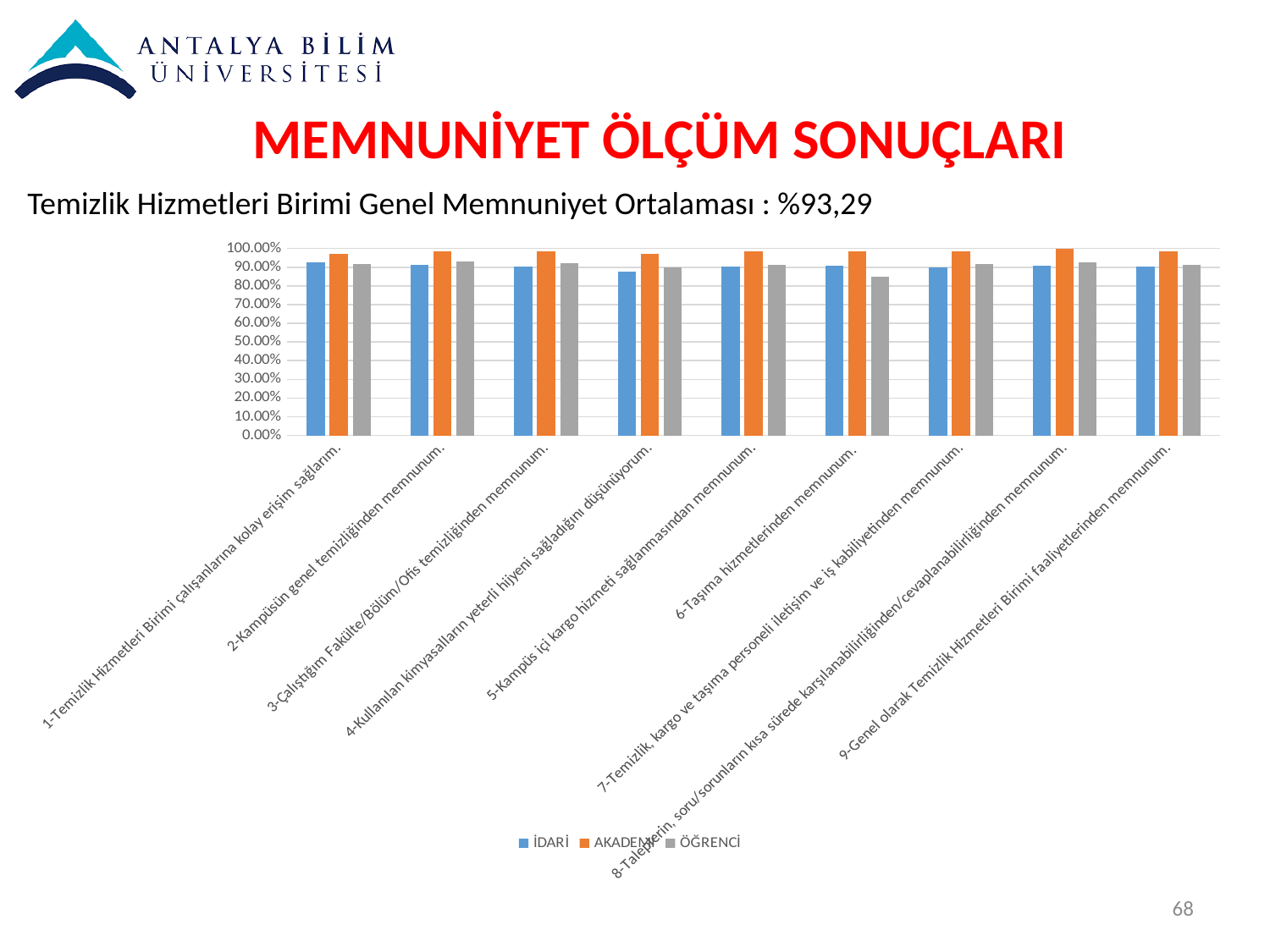
How many categories (survey statements) are shown on the x axis? 9 Which series is shown in grey in the legend? ÖĞRENCİ For "4-Kullanılan kimyasalların yeterli hijyeni sağladığını düşünüyorum.", which is larger: the İDARİ value or the AKADEMİ value? AKADEMİ Is the ÖĞRENCİ value for "6-Taşıma hizmetlerinden memnunum." greater or less than 90.00%? less Is the AKADEMİ value for "8-Taleplerin, soru/sorunların kısa sürede karşılanabilirliğinden/cevaplanabilirliğinden memnunum." greater or less than 90.00%? greater For which category is the ÖĞRENCİ value the lowest? 6-Taşıma hizmetlerinden memnunum. Is the AKADEMİ value for "6-Taşıma hizmetlerinden memnunum." greater or less than 90.00%? greater What kind of chart is shown on the slide? bar chart For "6-Taşıma hizmetlerinden memnunum.", which is larger: the AKADEMİ value or the ÖĞRENCİ value? AKADEMİ Which series is shown in orange in the legend? AKADEMİ How many series does the legend list? 3